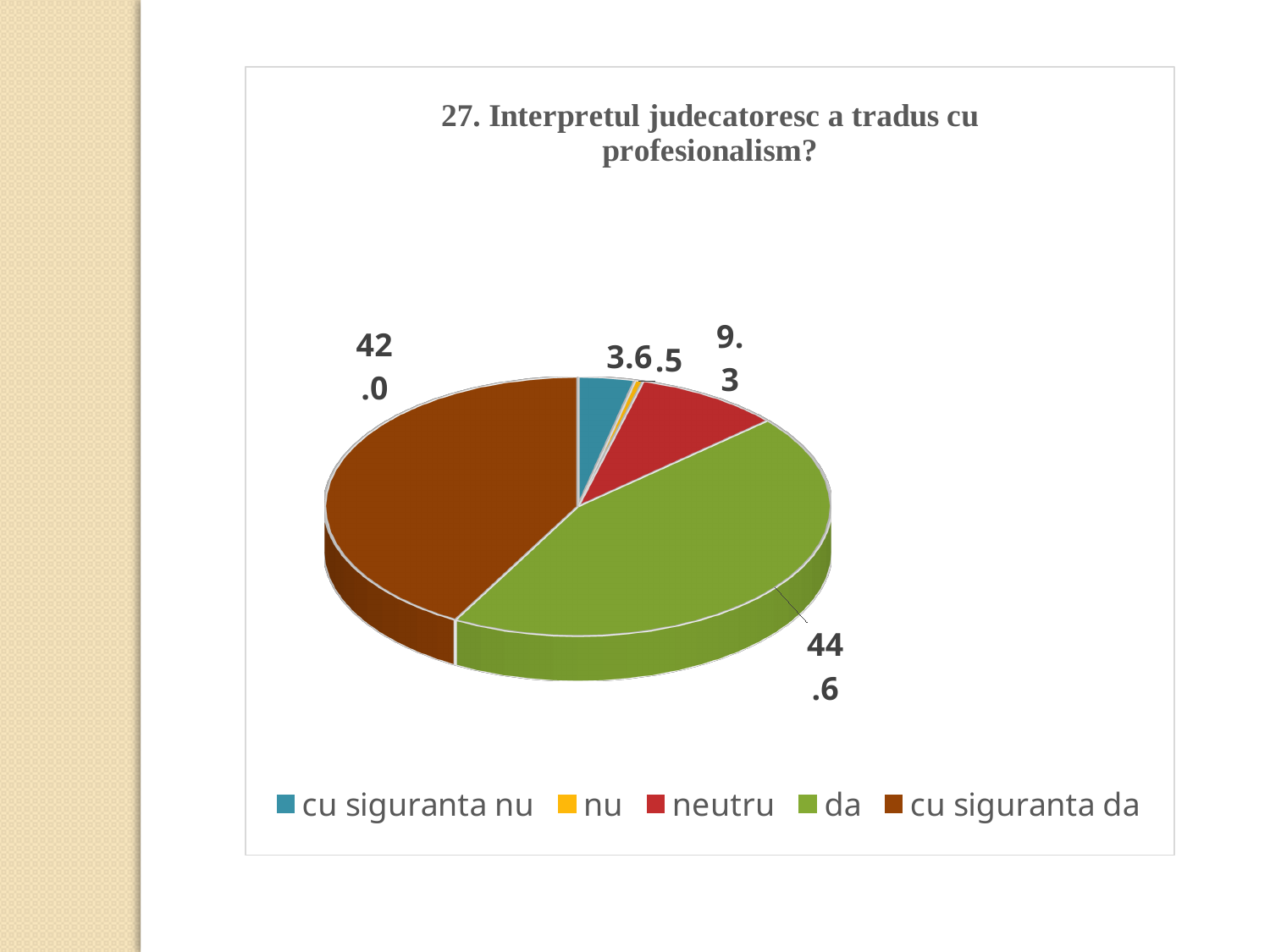
Which category has the largest slice of the pie? da What is the value shown for the "neutru" slice? 9.3 What is the value shown for the "cu siguranta da" slice? 42.0 Which category has the smallest slice of the pie? nu What is the title of the chart? 27. Interpretul judecatoresc a tradus cu profesionalism? What is the difference between the values for "neutru" and "cu siguranta nu"? 5.7 What is the value shown for the "cu siguranta nu" slice? 3.6 What is the difference between the values for "da" and "cu siguranta da"? 2.6 How many categories does the legend list? 5 Which is larger, the value for "da" or the value for "cu siguranta da"? da What is the value shown for the "da" slice? 44.6 What kind of chart is shown on the slide? pie chart